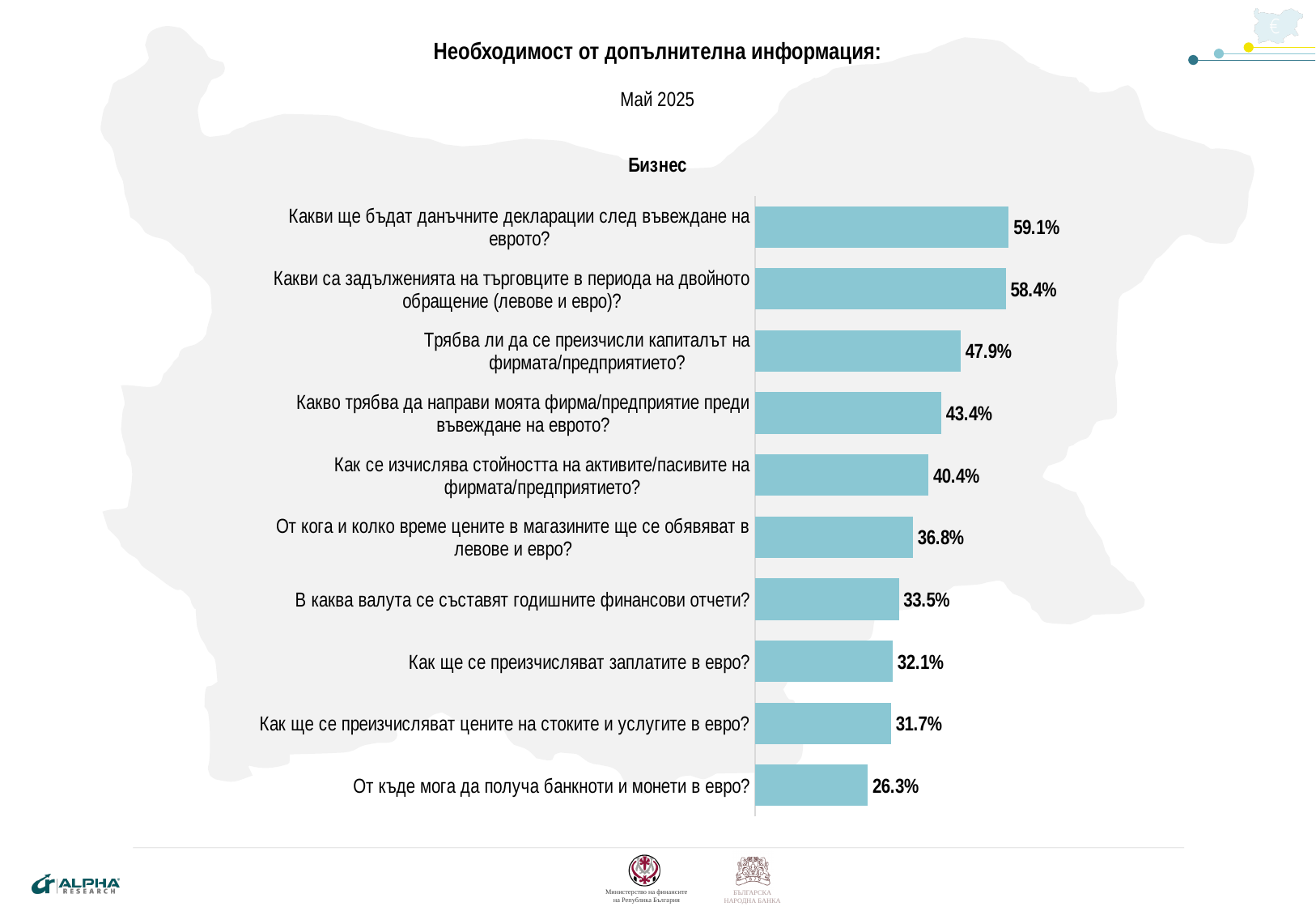
What type of chart is shown on the slide? bar chart Which is larger: the value for "В каква валута се съставят годишните финансови отчети?" or the value for "Как ще се преизчисляват цените на стоките и услугите в евро?"? В каква валута се съставят годишните финансови отчети? What is the difference between the values for "Какво трябва да направи моята фирма/предприятие преди въвеждане на еврото?" and "Как се изчислява стойността на активите/пасивите на фирмата/предприятието?"? 3.0% What is the difference between the values for "Какви ще бъдат данъчните декларации след въвеждане на еврото?" and "От къде мога да получа банкноти и монети в евро?"? 32.8% What is the value for "Трябва ли да се преизчисли капиталът на фирмата/предприятието?"? 47.9% What is the value for "Какви ще бъдат данъчните декларации след въвеждане на еврото?"? 59.1% How many categories are shown in the chart? 10 What is the value for "От къде мога да получа банкноти и монети в евро?"? 26.3% Which category has the lowest value? От къде мога да получа банкноти и монети в евро? Which month and year does the chart title refer to? Май 2025 Which category has the highest value? Какви ще бъдат данъчните декларации след въвеждане на еврото? What is the value for "Как ще се преизчисляват заплатите в евро?"? 32.1%